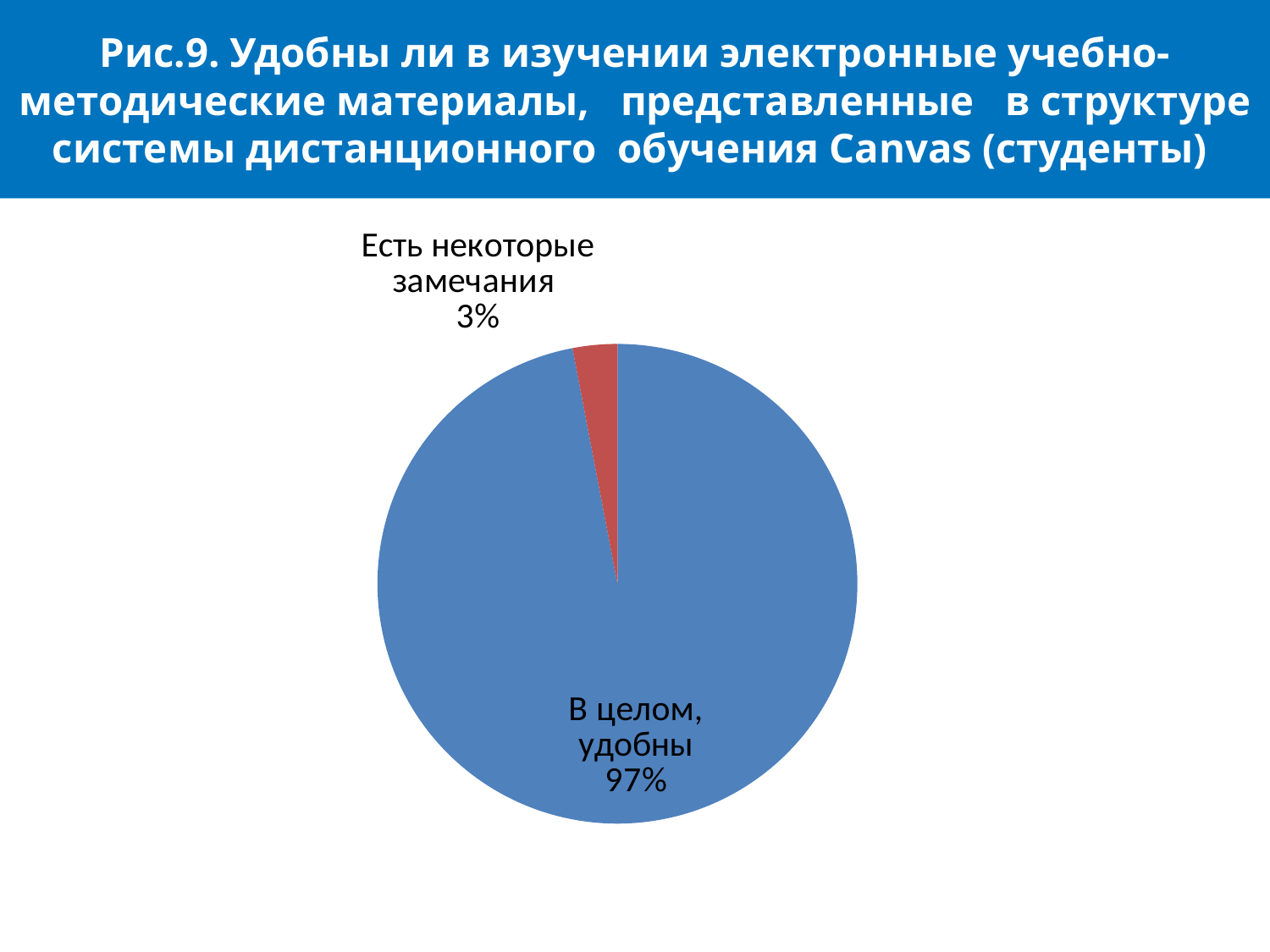
What colour is the slice for "Есть некоторые замечания"? red What share of the pie does "В целом, удобны" take? 97% Which category has the largest slice of the pie? В целом, удобны How many slices does the pie chart have? 2 Which is larger: the share for "В целом, удобны" or the share for "Есть некоторые замечания"? В целом, удобны What is the difference in percentage points between "В целом, удобны" and "Есть некоторые замечания"? 94 Which category has the smallest slice of the pie? Есть некоторые замечания What colour is the slice for "В целом, удобны"? blue What share of the pie does "Есть некоторые замечания" take? 3% What kind of chart is shown on the slide? pie chart